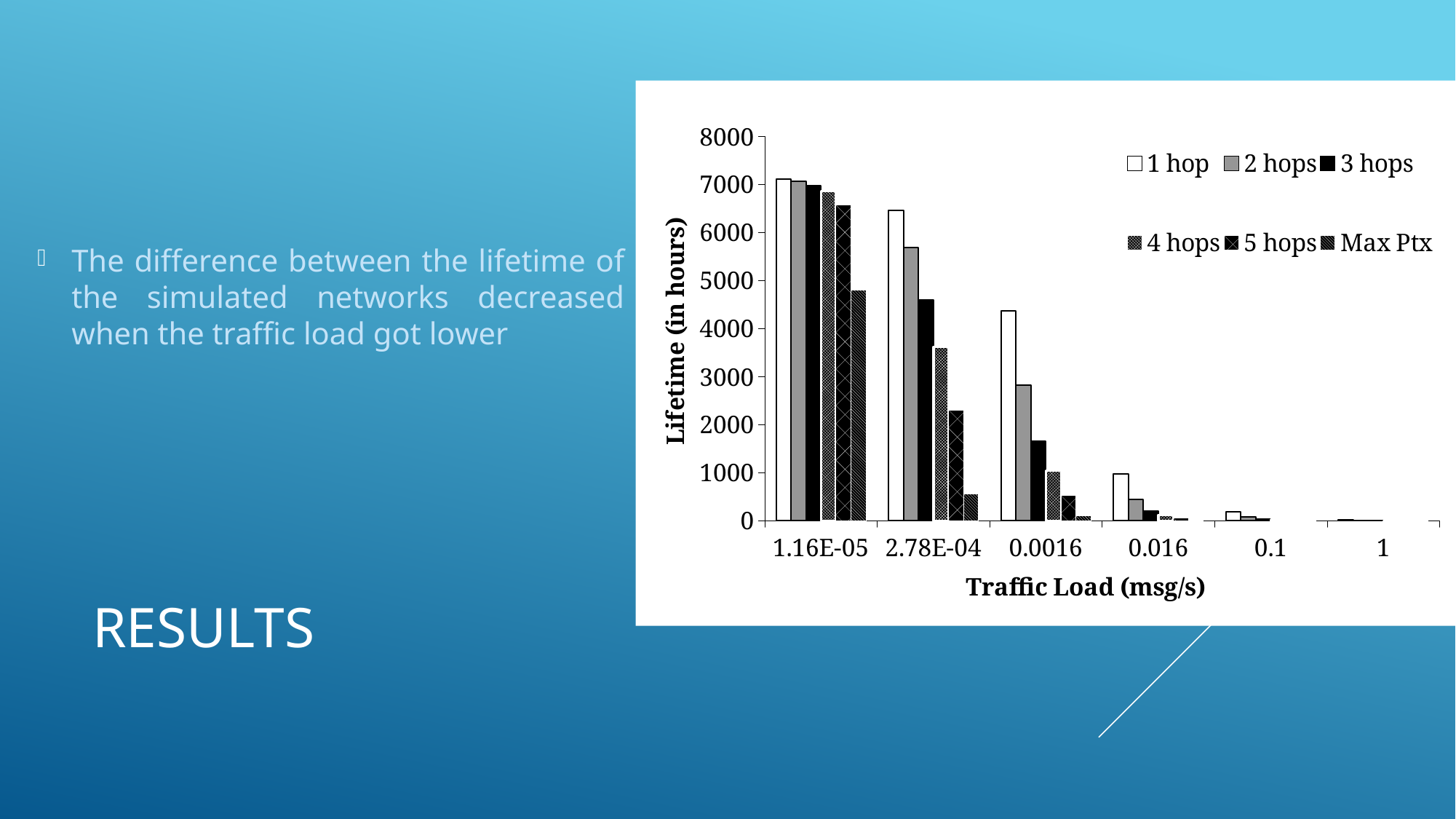
Does the lifetime for 1 hop rise or fall as the traffic load increases along the x axis? fall What kind of chart is shown on the slide? bar chart How many series does the legend list? 6 How many traffic load categories are shown on the x axis? 6 Is the value for 2 hops at traffic load 0.0016 greater or less than 3000? less Which series has the lowest lifetime at traffic load 1.16E-05? Max Ptx Which series has the highest lifetime at traffic load 0.0016? 1 hop Is the value for 1 hop at traffic load 1.16E-05 greater or less than 6000? greater Is the value for 1 hop at traffic load 0.016 greater or less than 500? greater What is the title of the y axis? Lifetime (in hours)